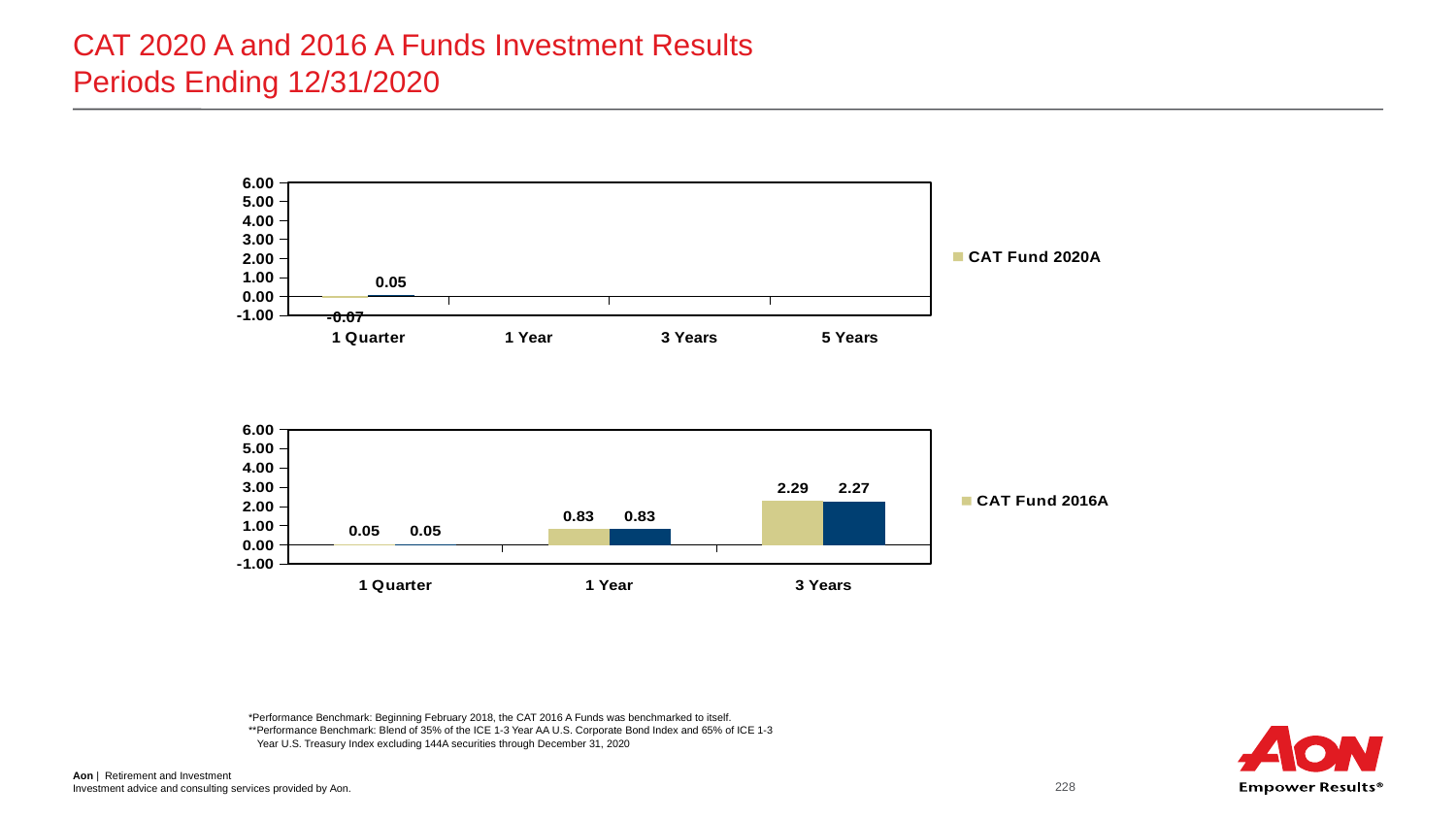
In the bottom chart, which category has the highest tan bar? 3 Years What kind of chart is the top chart on the slide? bar chart In the top chart, what value is labelled on the tan bar for 1 Quarter? -0.07 In the bottom chart, what is the difference between the tan bar values for 3 Years and 1 Year? 1.46 In the bottom chart, do the tan bar values rise or fall from 1 Quarter to 3 Years? rise How many categories are shown on the x axis of the bottom chart? 3 How many categories are shown on the x axis of the top chart? 4 In the bottom chart, what value is labelled on the tan bar for 1 Year? 0.83 In the top chart, what value is labelled on the blue bar for 1 Quarter? 0.05 What entry does the legend of the top chart list? CAT Fund 2020A In the bottom chart, what value is labelled on the blue bar for 3 Years? 2.27 In the bottom chart, what value is labelled on the tan bar for 3 Years? 2.29